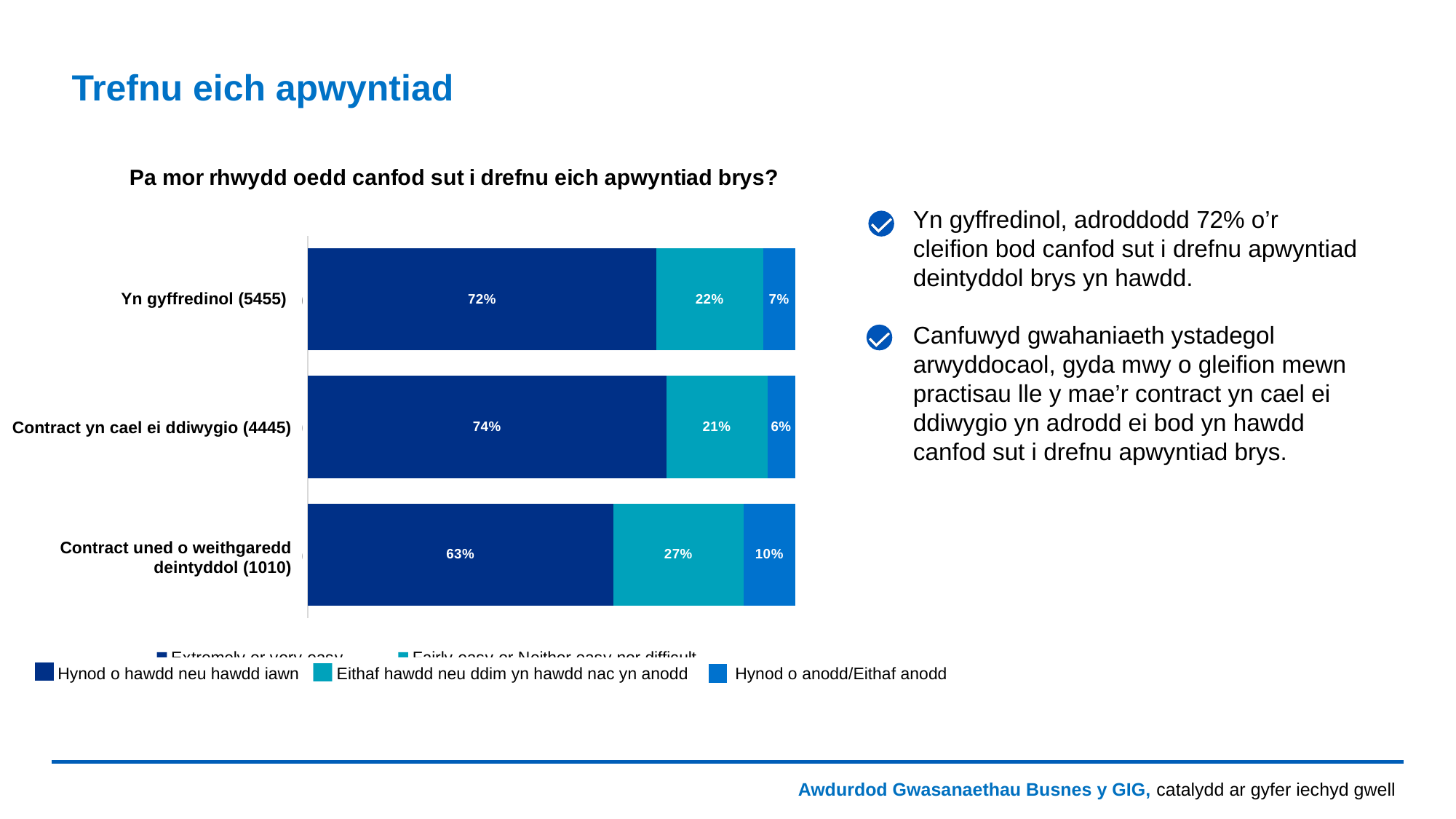
What is the 'Hynod o anodd/Eithaf anodd' value for 'Contract uned o weithgaredd deintyddol (1010)'? 10% Which category has the lowest 'Hynod o hawdd neu hawdd iawn' value? Contract uned o weithgaredd deintyddol (1010) What is the total of the three segments for 'Contract uned o weithgaredd deintyddol (1010)'? 100% What is the title of the chart? Pa mor rhwydd oedd canfod sut i drefnu eich apwyntiad brys? What percentage of 'Yn gyffredinol (5455)' respondents answered 'Hynod o hawdd neu hawdd iawn'? 72% Which category has the highest 'Hynod o hawdd neu hawdd iawn' value? Contract yn cael ei ddiwygio (4445) How many series does the legend list? 3 Which is larger: the 'Eithaf hawdd neu ddim yn hawdd nac yn anodd' value for 'Yn gyffredinol (5455)' or for 'Contract uned o weithgaredd deintyddol (1010)'? Contract uned o weithgaredd deintyddol (1010) What is the 'Eithaf hawdd neu ddim yn hawdd nac yn anodd' value for 'Contract yn cael ei ddiwygio (4445)'? 21% How many categories are shown on the chart? 3 What type of chart is shown on the slide? Stacked bar chart What is the difference between the 'Hynod o hawdd neu hawdd iawn' values for 'Contract yn cael ei ddiwygio (4445)' and 'Contract uned o weithgaredd deintyddol (1010)'? 11 percentage points